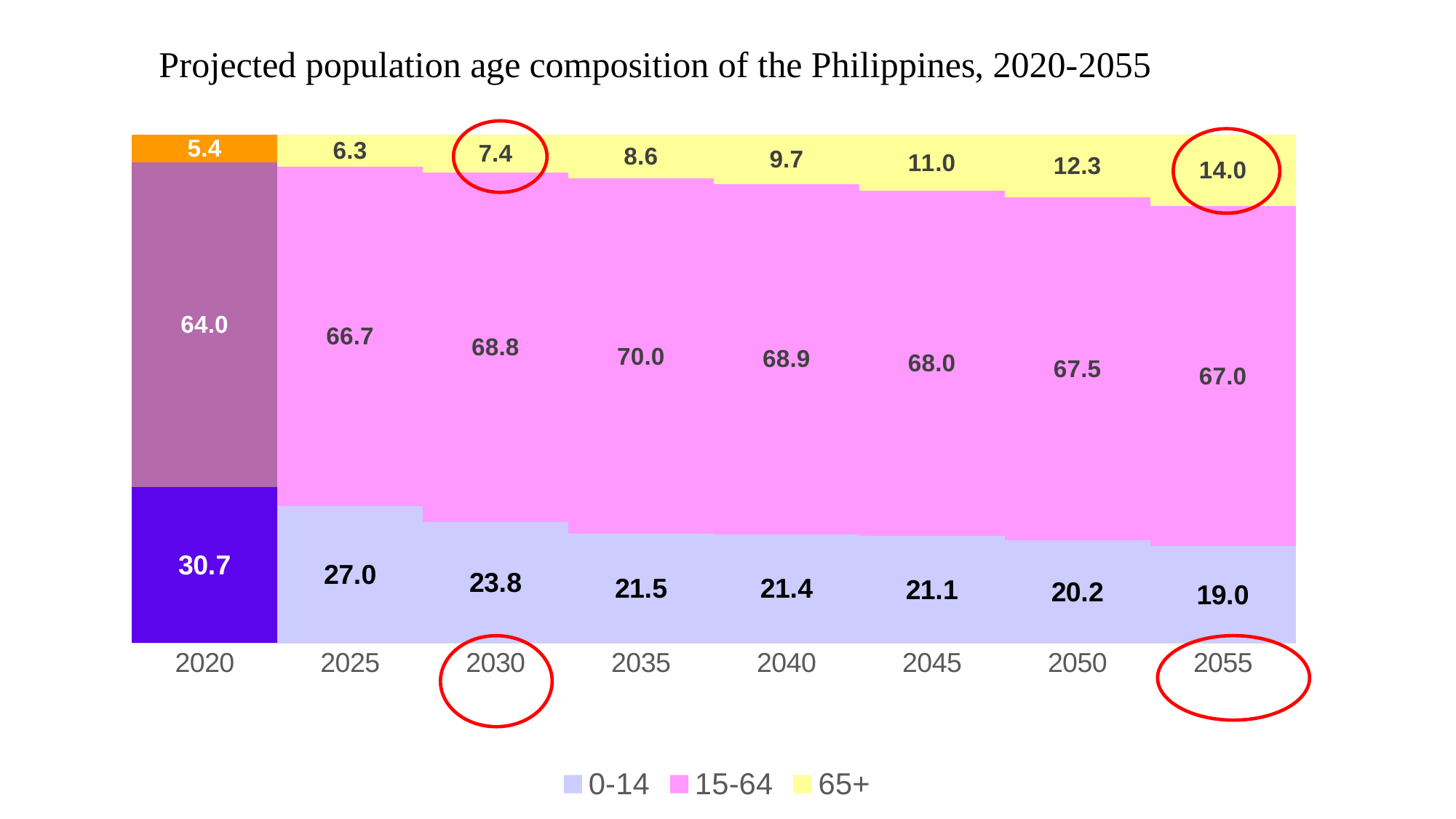
Which is larger: the 0-14 value in 2025 or the 65+ value in 2055? 0-14 value in 2025 What is the value for the 15-64 series in 2035? 70.0 What is the difference between the 65+ value in 2055 and the 65+ value in 2020? 8.6 In which year is the 15-64 series at its highest? 2035 How many years are shown on the x axis? 8 What is the value for the 65+ series in 2030? 7.4 What kind of chart is shown on the slide? Stacked bar chart In which year is the 0-14 series at its lowest? 2055 How many series does the legend list? 3 What is the value for the 0-14 series in 2020? 30.7 What is the total of the stacked bar for 2055? 100.0 Does the 65+ series rise or fall from 2020 to 2055? Rise